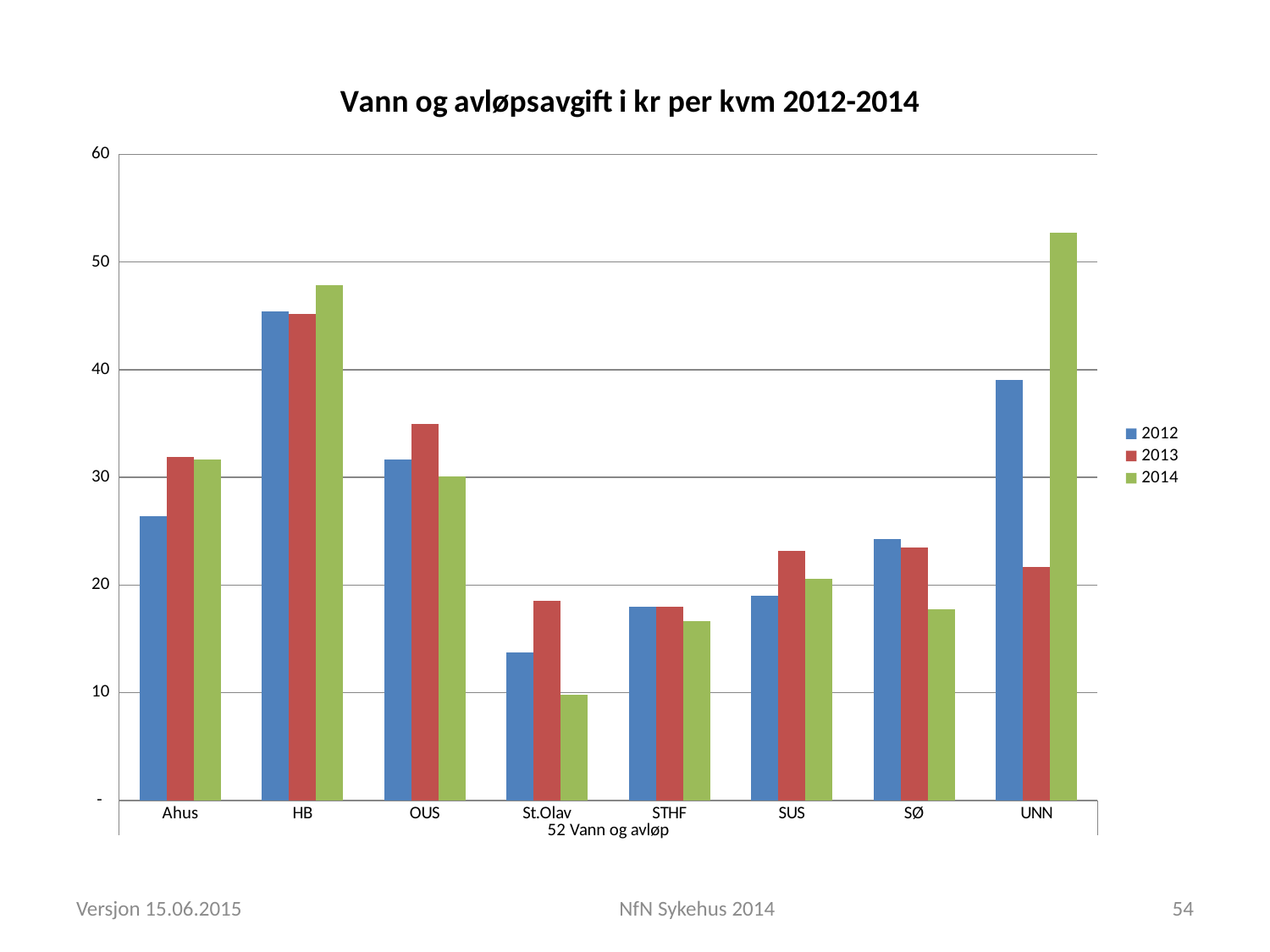
Which category has the lowest value for 2012? St.Olav Which category has the lowest value for 2014? St.Olav How many series does the legend list? 3 Is the value for OUS in 2013 greater or less than 30? greater Which category has the highest value for 2012? HB Which category has the highest value for 2014? UNN What is the title of the chart? Vann og avløpsavgift i kr per kvm 2012-2014 For UNN, which is larger: the value for 2012 or the value for 2013? 2012 Is the value for UNN in 2014 greater or less than 50? greater What kind of chart is shown on the slide? bar chart How many categories are shown on the x axis? 8